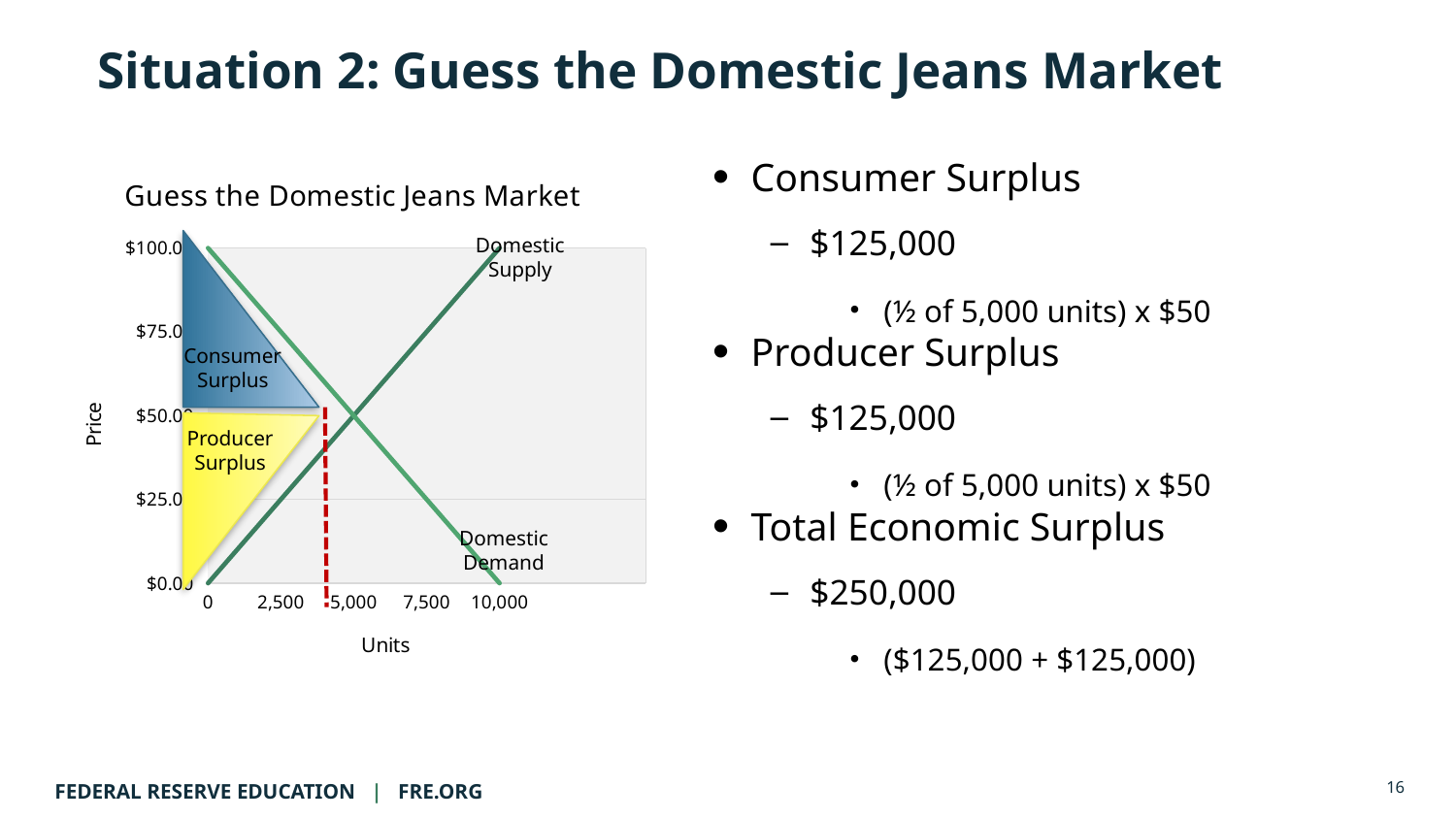
What kind of chart is shown on the slide? line chart At what price do the Domestic Supply and Domestic Demand lines cross? $50.00 What is the label of the horizontal axis of the chart? Units Does the Domestic Demand line rise or fall as units increase? fall What is the price on the Domestic Demand line at 0 units? $100.00 What is the title of the chart? Guess the Domestic Jeans Market Does the Domestic Supply line rise or fall as units increase? rise What is the highest price tick shown on the vertical axis? $100.00 How many lines are plotted on the chart? 2 What is the label of the vertical axis of the chart? Price Which shaded area lies above the $50.00 price level, Consumer Surplus or Producer Surplus? Consumer Surplus